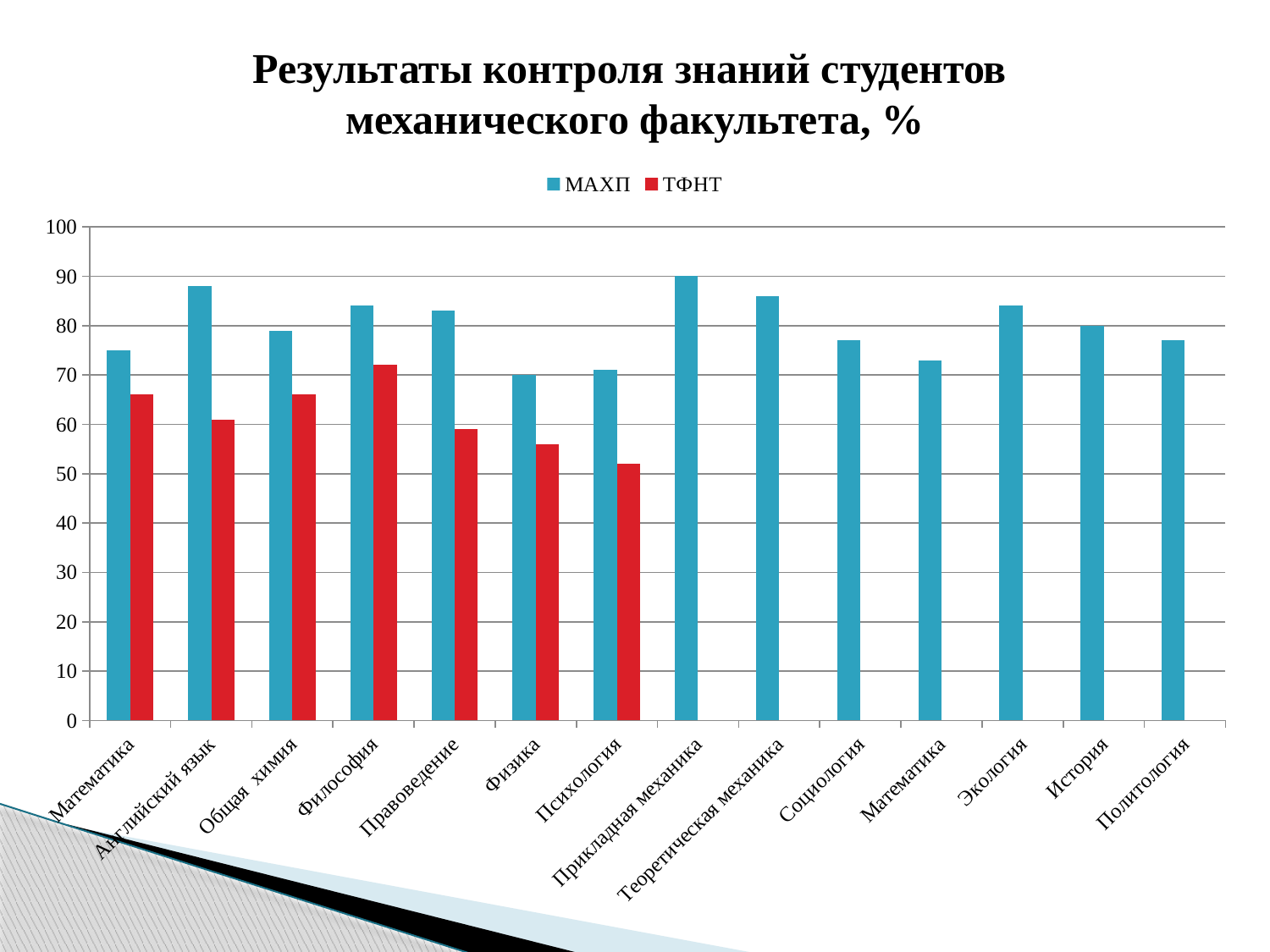
How many categories are shown along the x axis? 14 How many series does the legend list? 2 What kind of chart is shown on the slide? bar chart For Философия, which series has the larger value, МАХП or ТФНТ? МАХП Is the МАХП value for Теоретическая механика greater or less than 80? greater Is the МАХП value for Социология greater or less than 80? less For how many categories is a ТФНТ bar plotted? 7 Which category has the lowest ТФНТ value? Психология What are the two series named in the legend? МАХП and ТФНТ Which category has the highest ТФНТ value? Философия Is the МАХП value for Философия greater or less than 80? greater